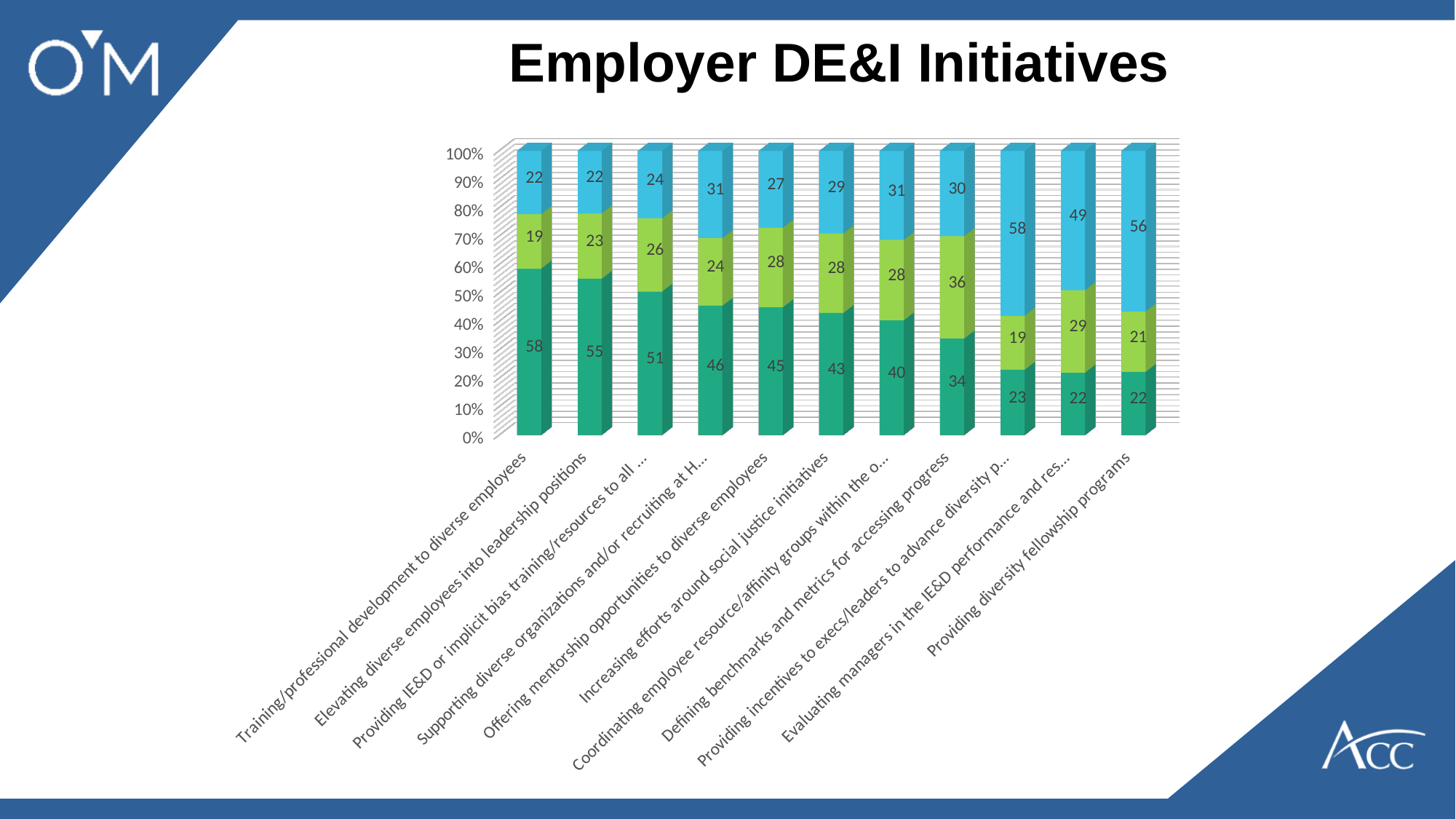
What is the value of the top (blue) segment for 'Providing diversity fellowship programs'? 56 Which has a larger bottom (dark green) segment: 'Elevating diverse employees into leadership positions' or 'Increasing efforts around social justice initiatives'? Elevating diverse employees into leadership positions What is the value of the middle (light green) segment for 'Defining benchmarks and metrics for accessing progress'? 36 What is the title of the chart? Employer DE&I Initiatives How many initiative categories are plotted on the x axis? 11 What is the value of the bottom (dark green) segment for 'Offering mentorship opportunities to diverse employees'? 45 Do the values of the bottom (dark green) segment rise or fall moving from left to right along the x axis? Fall What is the value of the bottom (dark green) segment for 'Training/professional development to diverse employees'? 58 Which category has the highest value in the top (blue) segment? Providing incentives to execs/leaders to advance diversity p... What kind of chart is shown on the slide? Stacked bar chart Which category has the highest value in the bottom (dark green) segment? Training/professional development to diverse employees What is the difference between the bottom (dark green) segment and the top (blue) segment for 'Training/professional development to diverse employees'? 36